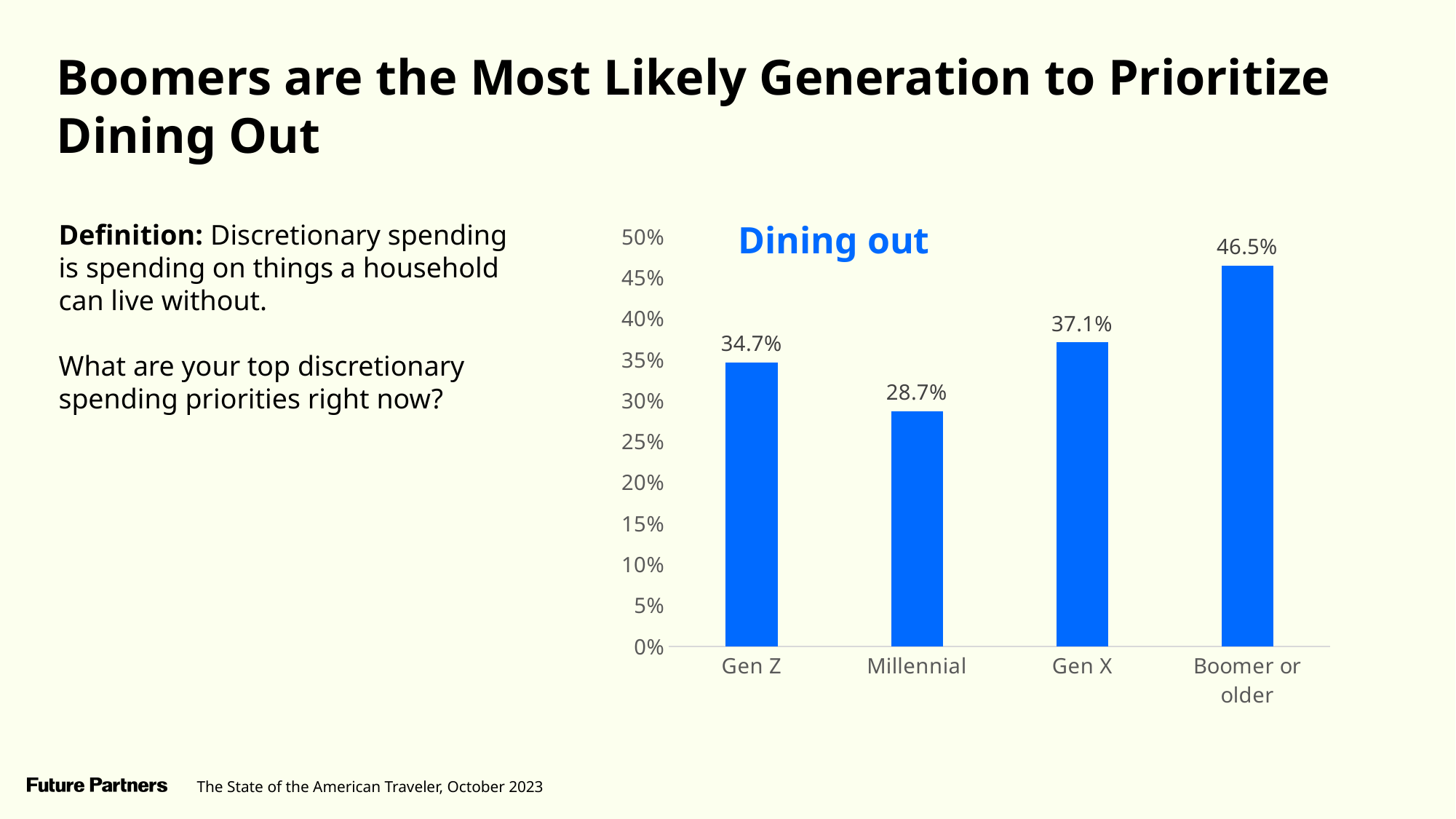
Which is larger, the value for Gen Z or the value for Gen X? Gen X What is the value for Gen X in the Dining out chart? 37.1% Which generation has the lowest value in the Dining out chart? Millennial What is the value for Gen Z in the Dining out chart? 34.7% What is the value for Boomer or older in the Dining out chart? 46.5% What kind of chart is shown on the slide? Bar chart Which generation has the highest value in the Dining out chart? Boomer or older What is the difference between the values for Boomer or older and Millennial? 17.8% How many generations are shown in the Dining out chart? 4 What is the difference between the values for Gen X and Gen Z? 2.4% What is the title of the chart? Dining out What is the value for Millennial in the Dining out chart? 28.7%